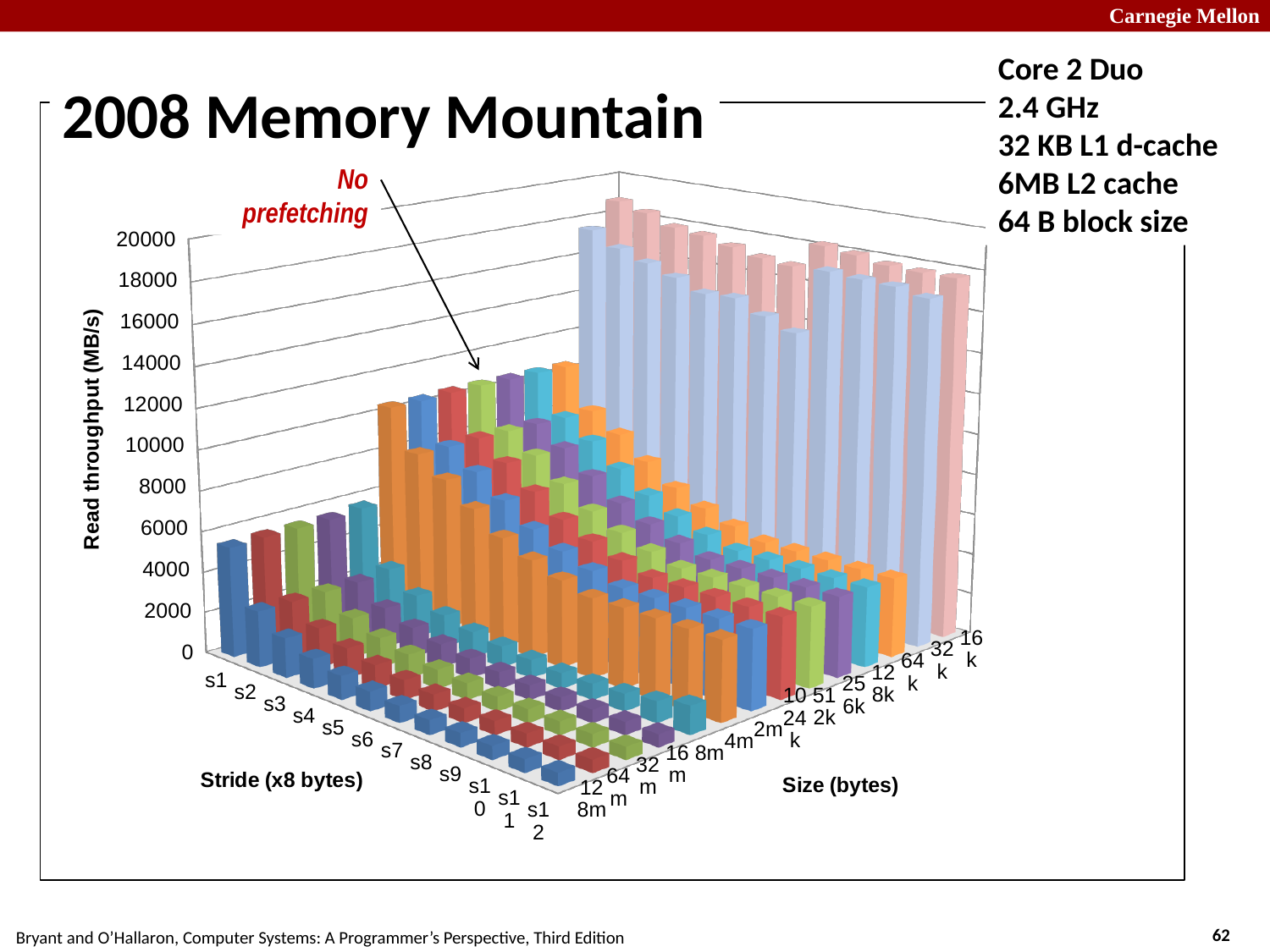
Is the read throughput for stride s12 at size 16k greater or less than 14000? greater Is the read throughput for stride s1 at size 8m (front-left bar) greater or less than 8000? less What is the highest tick value shown on the vertical axis? 20000 For the largest size (front row), does read throughput rise or fall as stride increases from s1 to s12? fall Is the read throughput for stride s12 at size 8m (front-right corner) greater or less than 2000? less What is the title of the chart? 2008 Memory Mountain How many stride categories are shown on the stride axis? 12 What kind of chart is shown on the slide? 3D bar chart What is the label on the vertical axis of the chart? Read throughput (MB/s) Which is larger: the read throughput for stride s1 at size 16k or for stride s1 at size 8m? stride s1 at size 16k